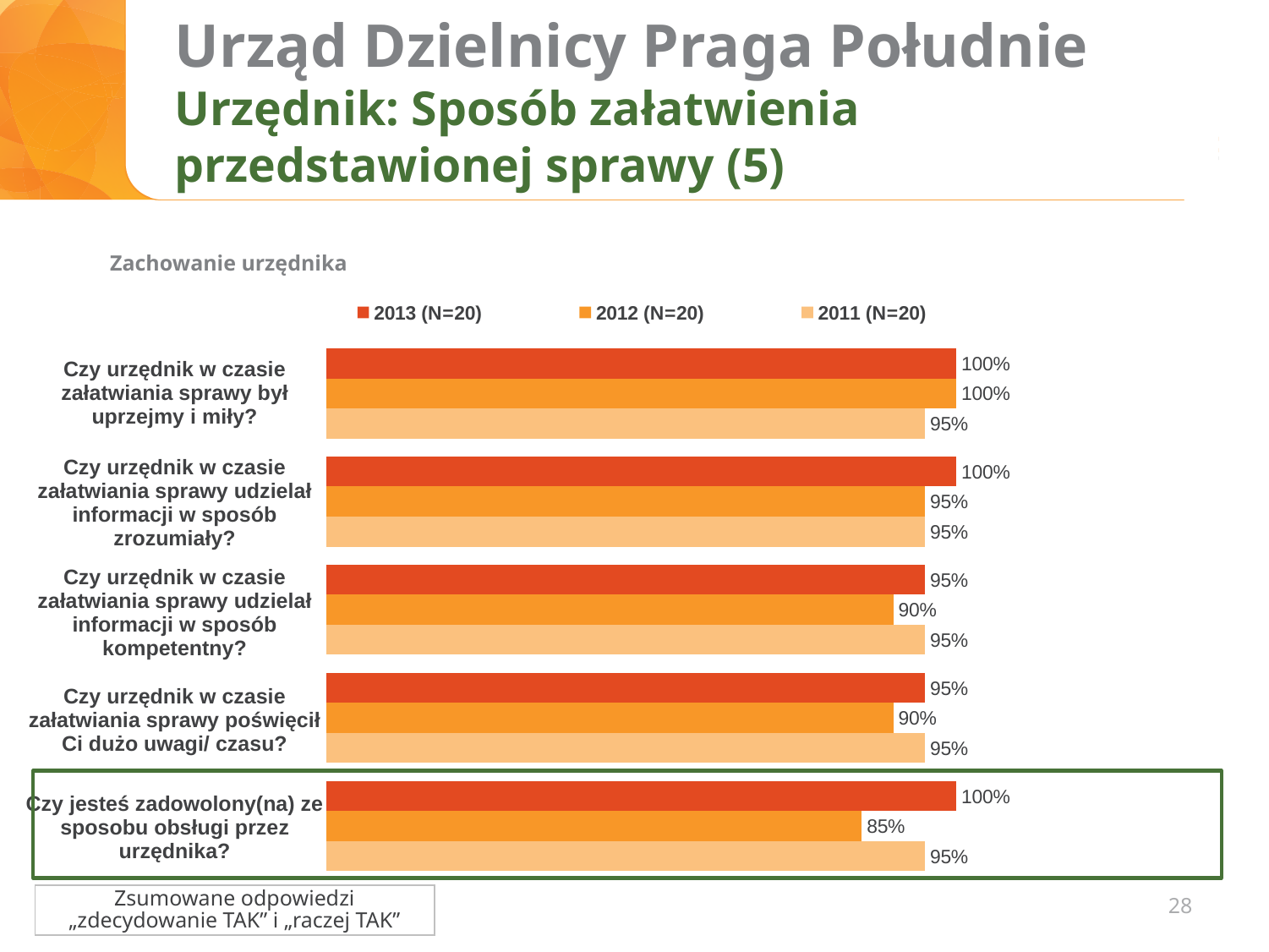
How many series does the legend list? 3 What is the title of the chart? Zachowanie urzędnika Which question has the lowest 2012 (N=20) value? Czy jesteś zadowolony(na) ze sposobu obsługi przez urzędnika? For "Czy urzędnik w czasie załatwiania sprawy poświęcił Ci dużo uwagi/ czasu?", which is larger: the 2013 (N=20) value or the 2012 (N=20) value? 2013 (N=20) What is the 2011 (N=20) value for "Czy urzędnik w czasie załatwiania sprawy był uprzejmy i miły?"? 95% What is the 2012 (N=20) value for "Czy jesteś zadowolony(na) ze sposobu obsługi przez urzędnika?"? 85% What is the difference between the 2013 (N=20) and 2012 (N=20) values for "Czy jesteś zadowolony(na) ze sposobu obsługi przez urzędnika?"? 15% What is the 2012 (N=20) value for "Czy urzędnik w czasie załatwiania sprawy udzielał informacji w sposób kompetentny?"? 90% What kind of chart is shown on the slide? Bar chart What is the 2013 (N=20) value for "Czy jesteś zadowolony(na) ze sposobu obsługi przez urzędnika?"? 100% What is the difference between the 2013 (N=20) and 2011 (N=20) values for "Czy urzędnik w czasie załatwiania sprawy udzielał informacji w sposób zrozumiały?"? 5% How many questions (categories) are shown in the chart? 5